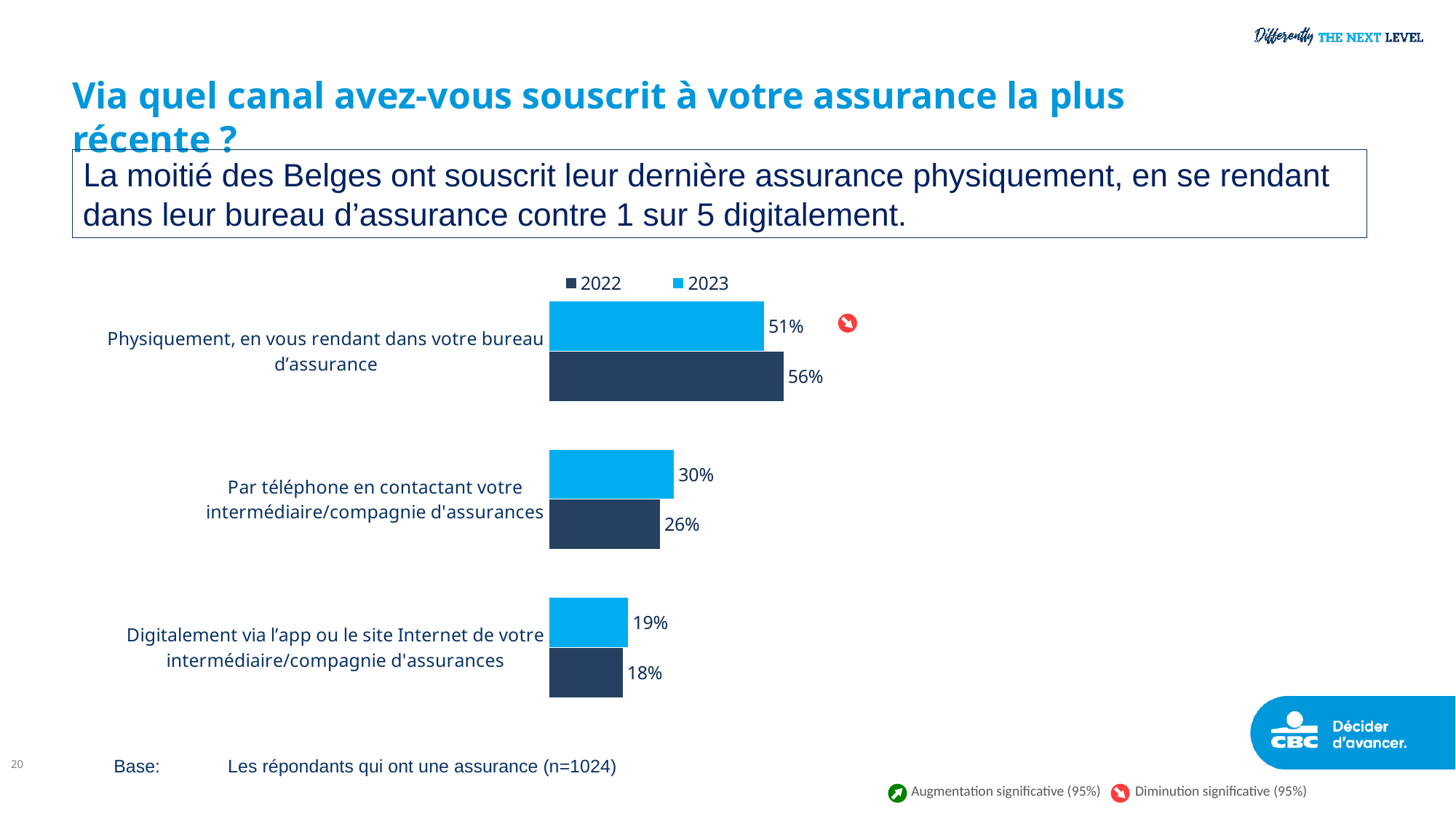
How many series does the legend list? 2 Which channel has the lowest 2022 value? Digitalement via l'app ou le site Internet de votre intermédiaire/compagnie d'assurances What is the difference between the 2022 and 2023 values for 'Physiquement, en vous rendant dans votre bureau d'assurance'? 5% What is the 2022 value for 'Digitalement via l'app ou le site Internet de votre intermédiaire/compagnie d'assurances'? 18% What is the 2023 value for 'Par téléphone en contactant votre intermédiaire/compagnie d'assurances'? 30% What kind of chart is shown on the slide? Bar chart What is the 2022 value for 'Physiquement, en vous rendant dans votre bureau d'assurance'? 56% Which channel has the highest 2023 value? Physiquement, en vous rendant dans votre bureau d'assurance What is the 2023 value for 'Physiquement, en vous rendant dans votre bureau d'assurance'? 51% For 'Par téléphone en contactant votre intermédiaire/compagnie d'assurances', which year has the larger value, 2022 or 2023? 2023 How many channel categories are shown in the chart? 3 What is the difference between the 2023 and 2022 values for 'Par téléphone en contactant votre intermédiaire/compagnie d'assurances'? 4%